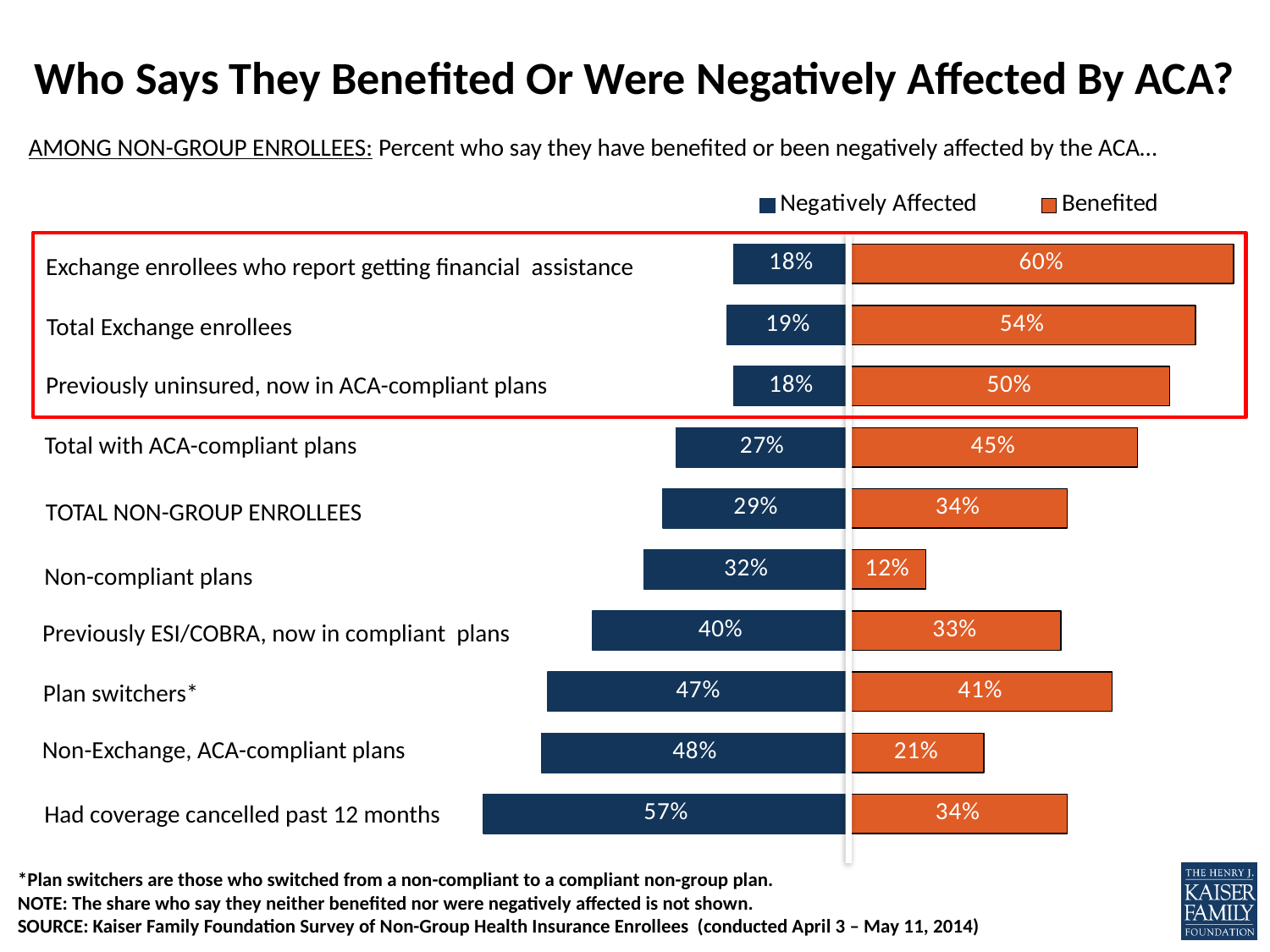
What percent of those who had coverage cancelled in the past 12 months say they were negatively affected by the ACA? 57% How many series does the legend list? 2 Which category has the lowest Negatively Affected percentage? Exchange enrollees who report getting financial assistance and Previously uninsured, now in ACA-compliant plans (both 18%) What is the difference in the Benefited percentage between Exchange enrollees who report getting financial assistance and Non-Exchange, ACA-compliant plans? 39 percentage points What percent of Non-compliant plans enrollees say they benefited from the ACA? 12% Which category has the highest Benefited percentage? Exchange enrollees who report getting financial assistance For Plan switchers*, which is larger: the Negatively Affected share or the Benefited share? Negatively Affected How many categories are shown in the chart? 10 What kind of chart is shown on the slide? Bar chart Which colour represents the Benefited series in the chart? Orange What is the difference between the Benefited and Negatively Affected percentages for TOTAL NON-GROUP ENROLLEES? 5 percentage points What percent of Total Exchange enrollees say they benefited from the ACA? 54%